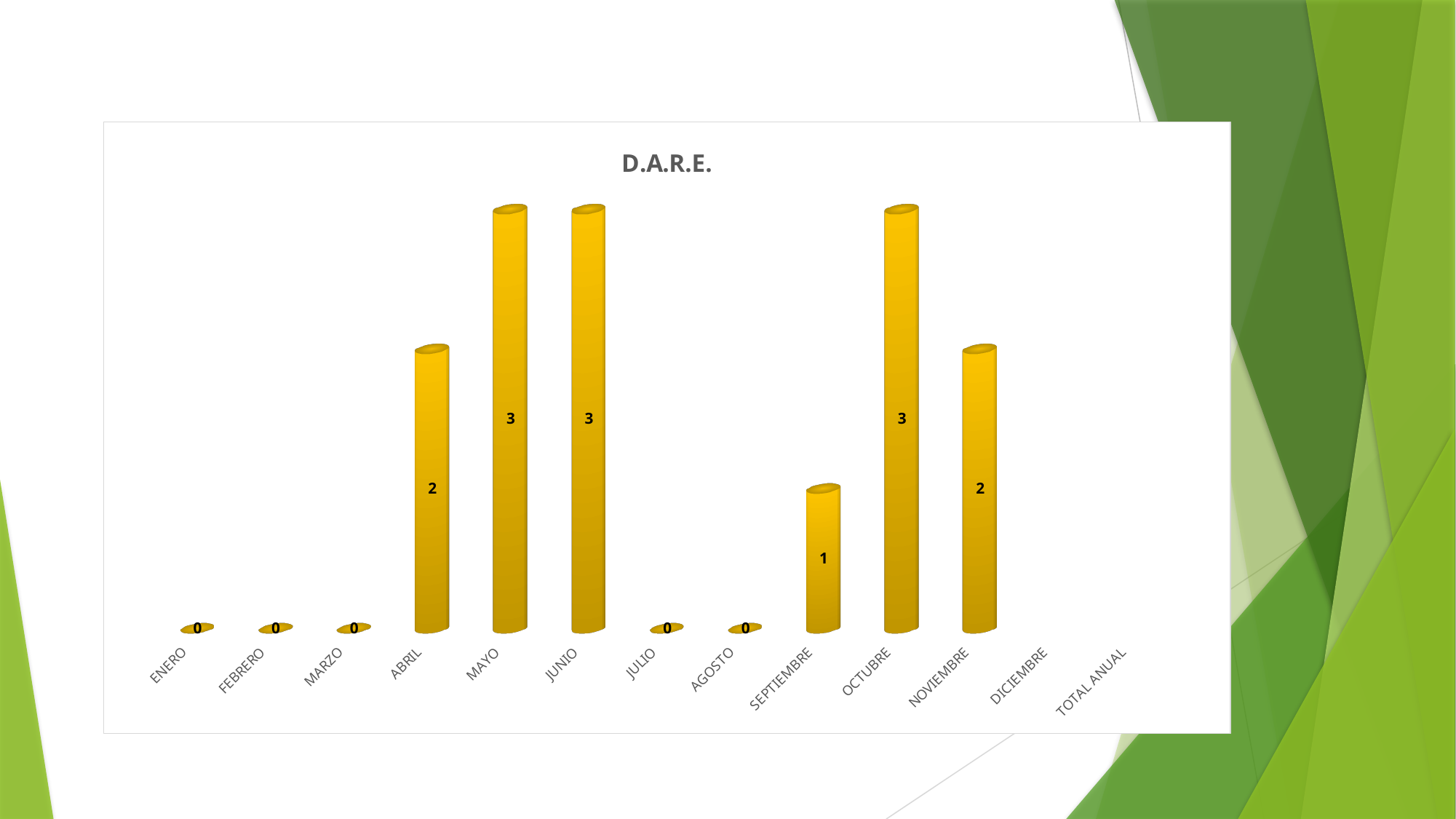
What is the value for SEPTIEMBRE? 1 What is the value for NOVIEMBRE? 2 What is the value for ABRIL in the D.A.R.E. chart? 2 Which has the larger value, SEPTIEMBRE or NOVIEMBRE? NOVIEMBRE What is the difference between the values for OCTUBRE and SEPTIEMBRE? 2 What is the value for ENERO? 0 What kind of chart is shown on the slide? bar chart What is the title of the chart? D.A.R.E. How many categories are listed along the x axis of the chart? 13 What is the value for MAYO? 3 What is the difference between the values for MAYO and ABRIL? 1 Which has the larger value, ABRIL or JUNIO? JUNIO